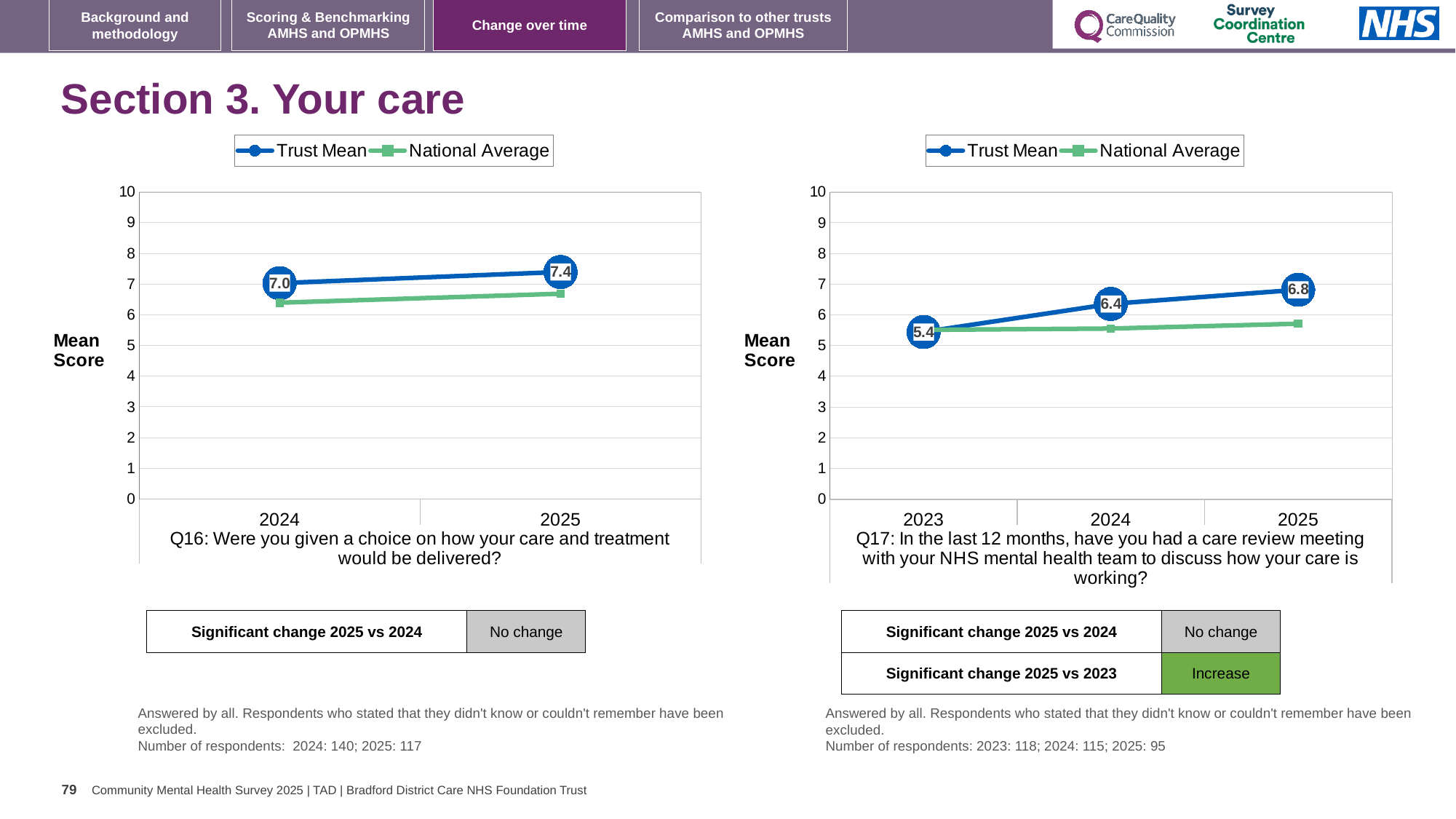
In the Q16 chart on the left, how many series does the legend list? 2 In the Q16 chart on the left, what is the Trust Mean for 2024? 7.0 In the Q16 chart on the left, what is the Trust Mean for 2025? 7.4 In the Q17 chart on the right, what is the Trust Mean for 2025? 6.8 In the Q16 chart on the left, by how much did the Trust Mean change from 2024 to 2025? 0.4 In the Q17 chart on the right, which year has the lowest Trust Mean? 2023 In the Q17 chart on the right, what is the Trust Mean for 2023? 5.4 In the Q17 chart on the right, how many years are shown on the x axis? 3 In the Q16 chart on the left, is the National Average for 2024 greater or less than 7? less In the Q17 chart on the right, does the Trust Mean rise or fall from 2023 to 2025? rise What kind of chart is the Q17 chart on the right? line chart In the Q17 chart on the right, what is the difference between the Trust Mean in 2025 and in 2023? 1.4